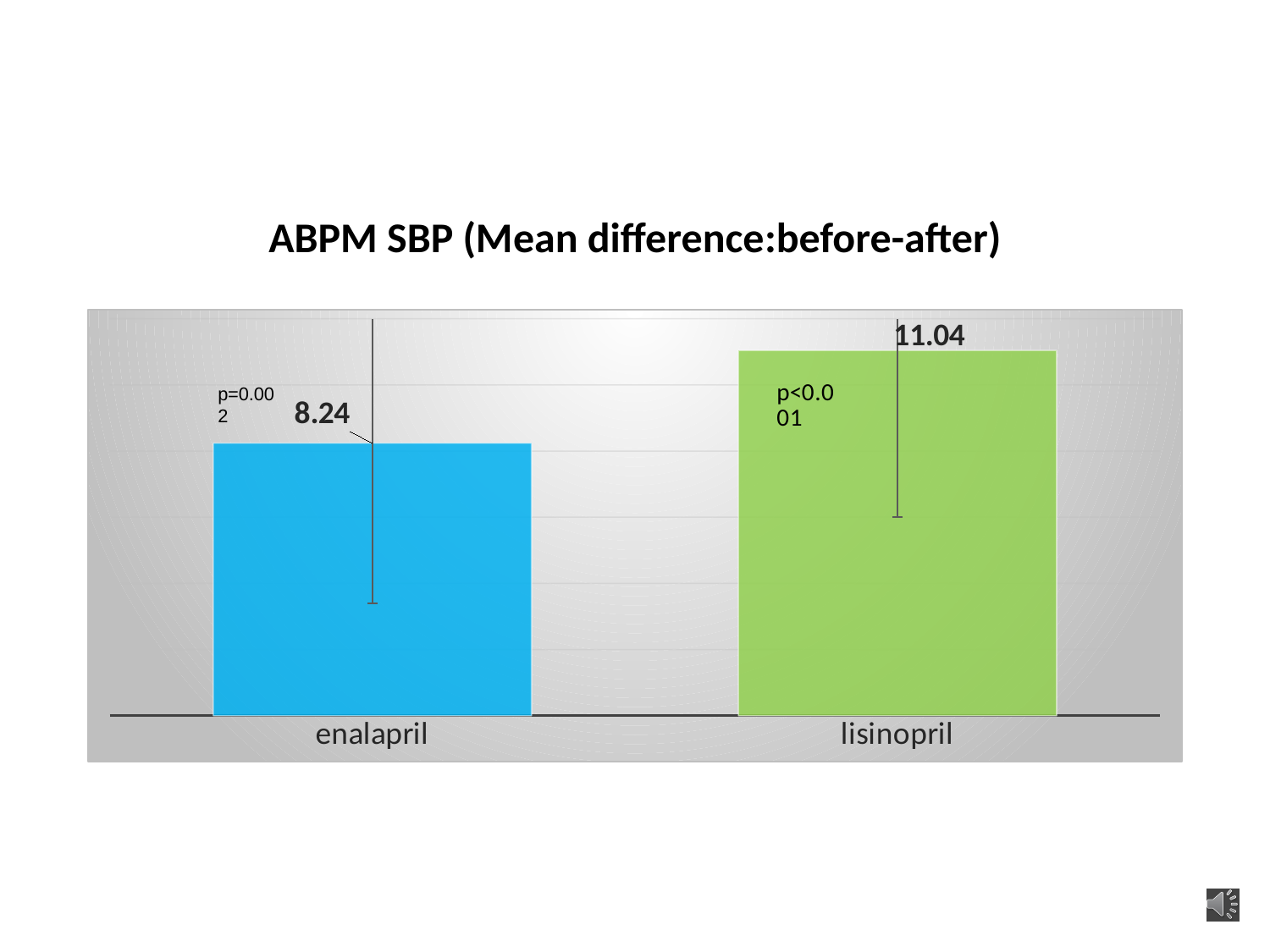
Which is larger, the value for enalapril or the value for lisinopril? lisinopril Which category has the highest value? lisinopril What is the value for lisinopril? 11.04 What is the difference between the values for lisinopril and enalapril? 2.80 Which category has the lowest value? enalapril What kind of chart is shown on the slide? bar chart What is the title of the chart? ABPM SBP (Mean difference:before-after) What is the value for enalapril? 8.24 How many categories are shown on the chart? 2 What p-value is shown for lisinopril? p<0.001